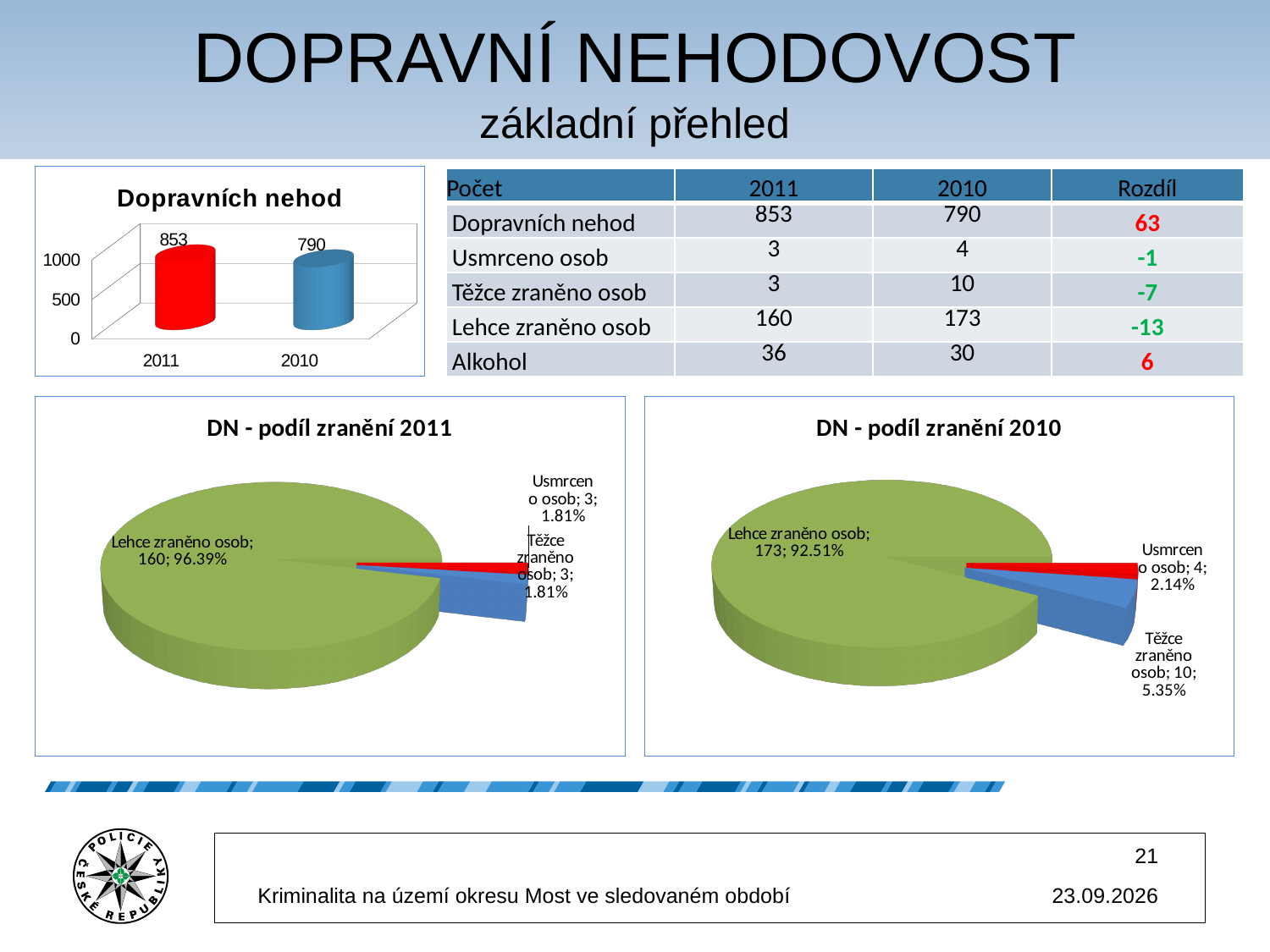
In the 'Dopravních nehod' chart, what is the difference between the 2011 and 2010 values? 63 In the 'DN - podíl zranění 2010' chart, which category is the largest? Lehce zraněno osob In the 'DN - podíl zranění 2010' chart, what share of the pie is Usmrceno osob? 2.14% How many slices does the 'DN - podíl zranění 2010' pie chart have? 3 In the 'Dopravních nehod' chart, what is the value for 2010? 790 In the 'DN - podíl zranění 2010' chart, what is the value for Těžce zraněno osob? 10 What kind of chart is 'Dopravních nehod'? Bar chart In the 'Dopravních nehod' chart, which year has the higher value? 2011 In the 'DN - podíl zranění 2011' chart, what share of the pie is Lehce zraněno osob? 96.39% In the 'Dopravních nehod' chart, what is the value for 2011? 853 In the 'Dopravních nehod' chart, is the value for 2010 greater or less than 500? greater In the 'DN - podíl zranění 2011' chart, what is the value for Lehce zraněno osob? 160